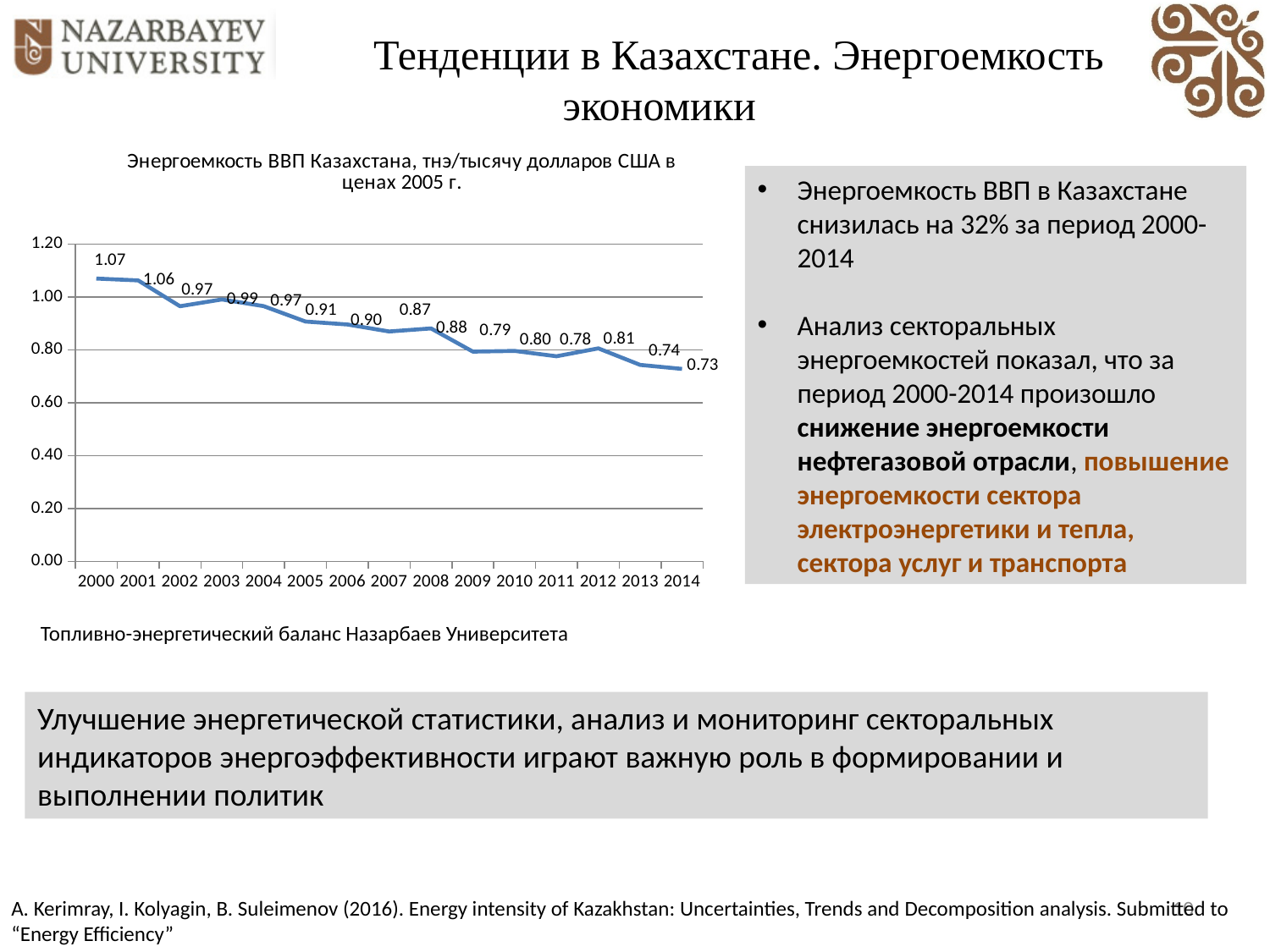
What is the title of the chart? Энергоемкость ВВП Казахстана, тнэ/тысячу долларов США в ценах 2005 г. What is the energy intensity value for 2000? 1.07 Which is larger, the value for 2003 or the value for 2005? 2003 What type of chart is shown on the slide? Line chart What is the difference between the values for 2000 and 2014? 0.34 Which year has the highest value on the chart? 2000 What is the value plotted for 2007? 0.87 Which year has the lowest value on the chart? 2014 Do the values generally rise or fall from 2000 to 2014? Fall What is the value plotted for 2012? 0.81 What is the energy intensity value for 2014? 0.73 How many years are plotted on the x axis? 15